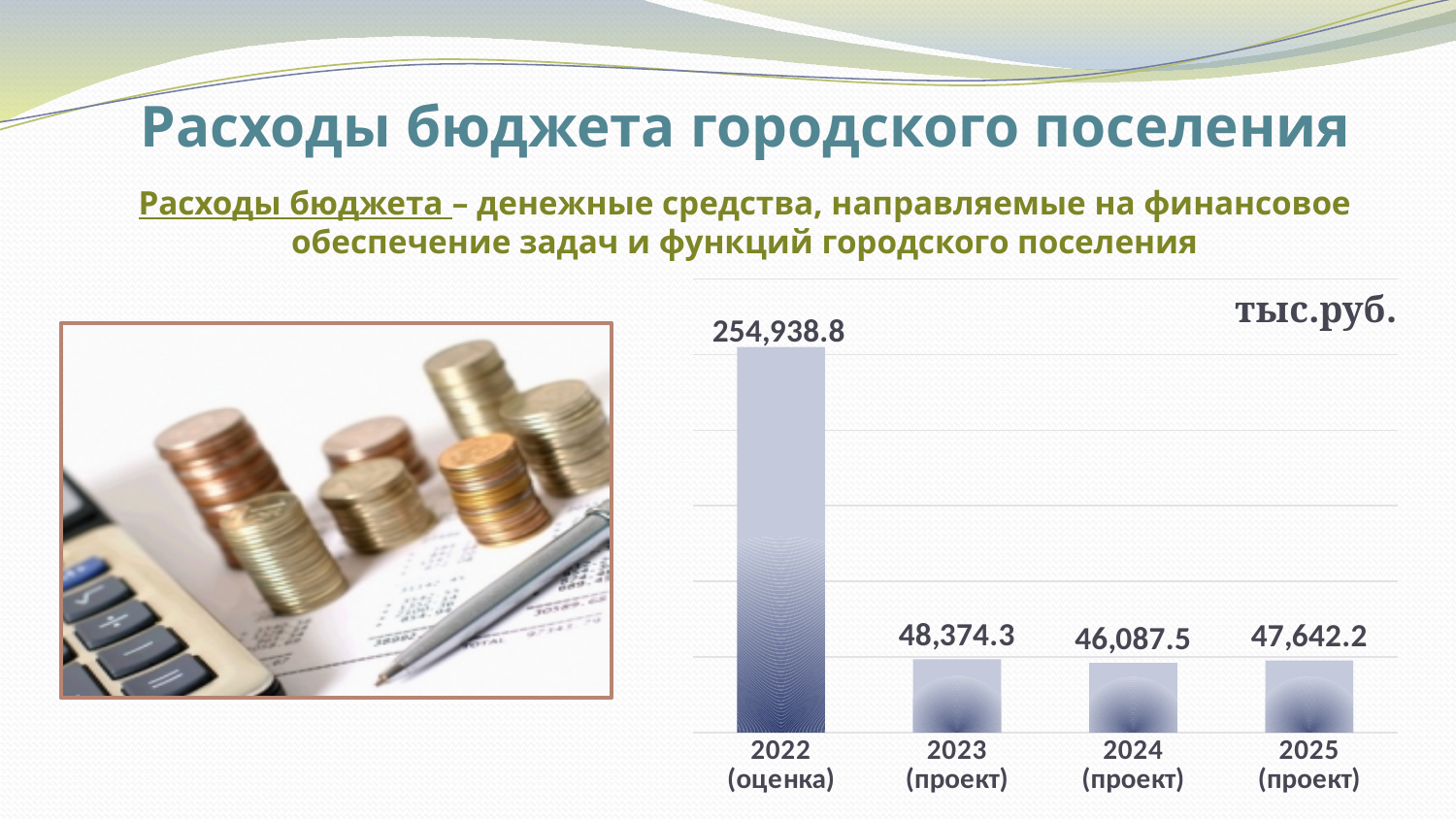
In what units are the chart values given? тыс.руб. Which year has the highest value? 2022 (оценка) What is the difference between the values for 2025 (проект) and 2024 (проект)? 1,554.7 How many bars are shown in the chart? 4 What is the value for 2022 (оценка)? 254,938.8 What is the difference between the values for 2022 (оценка) and 2023 (проект)? 206,564.5 What is the value for 2024 (проект)? 46,087.5 What is the value for 2023 (проект)? 48,374.3 What kind of chart is shown on the slide? bar chart Which is larger, the value for 2023 (проект) or the value for 2025 (проект)? 2023 (проект) What is the value for 2025 (проект)? 47,642.2 Which year has the lowest value? 2024 (проект)